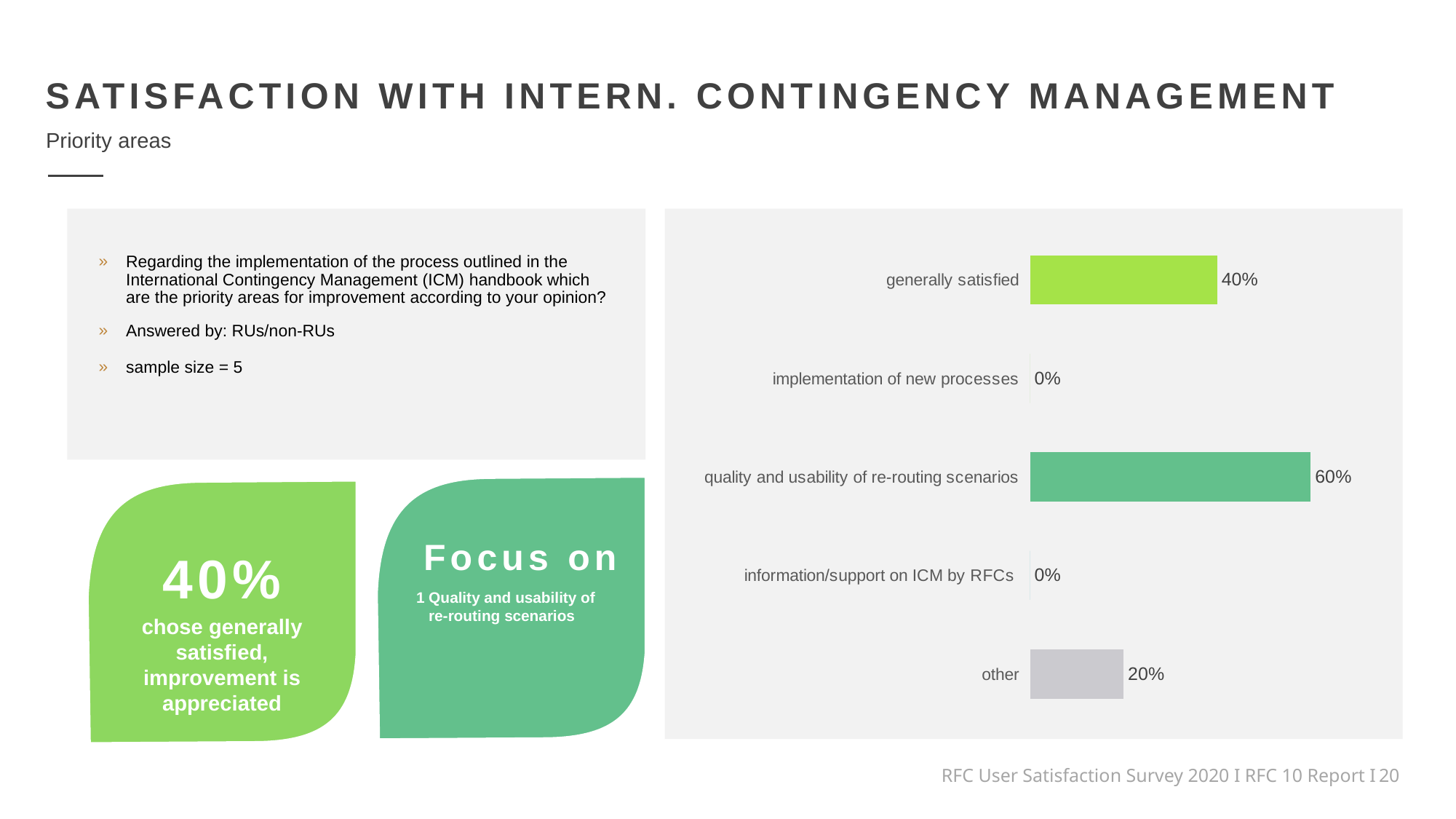
How many categories have a value of 0%? 2 What is the value for 'quality and usability of re-routing scenarios'? 60% Which is larger, 'generally satisfied' or 'other'? generally satisfied What is the value for 'information/support on ICM by RFCs'? 0% What is the difference between 'generally satisfied' and 'other'? 20% What is the value for 'generally satisfied'? 40% What is the value for 'other'? 20% Which category has the highest value? quality and usability of re-routing scenarios How many categories are shown in the chart? 5 What is the difference between 'quality and usability of re-routing scenarios' and 'generally satisfied'? 20% What kind of chart is shown on the slide? bar chart What is the value for 'implementation of new processes'? 0%